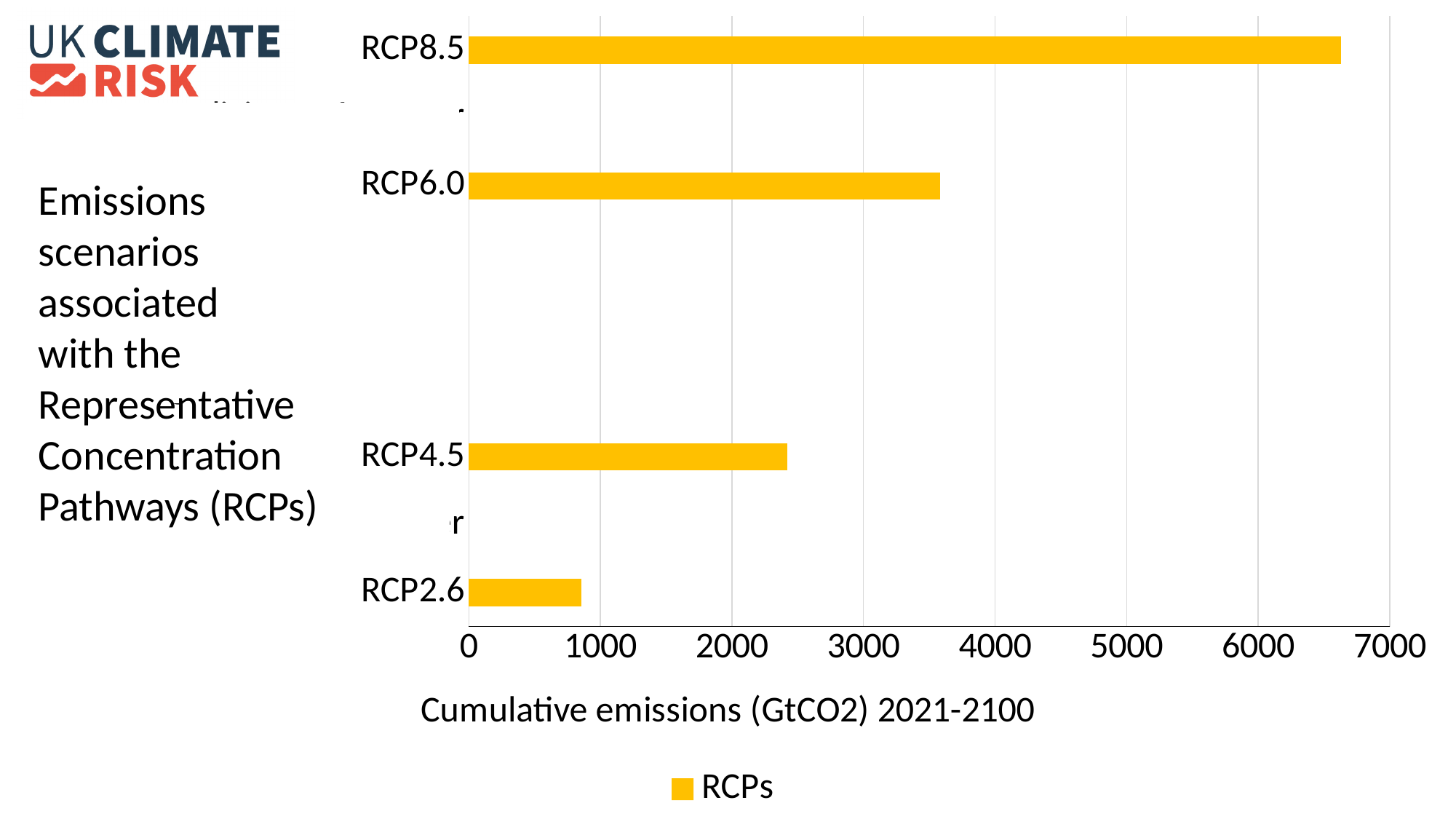
How many RCP scenarios are plotted in the chart? 4 Which has higher cumulative emissions, RCP6.0 or RCP4.5? RCP6.0 Is the value for RCP2.6 greater or less than 1000? less Which scenario has the lowest cumulative emissions? RCP2.6 Is the value for RCP4.5 greater or less than 3000? less What series name appears in the chart legend? RCPs Is the value for RCP6.0 greater or less than 3000? greater What kind of chart is shown on the slide? bar chart Which scenario has the highest cumulative emissions? RCP8.5 How many series does the chart legend list? 1 What is the label of the horizontal axis? Cumulative emissions (GtCO2) 2021-2100